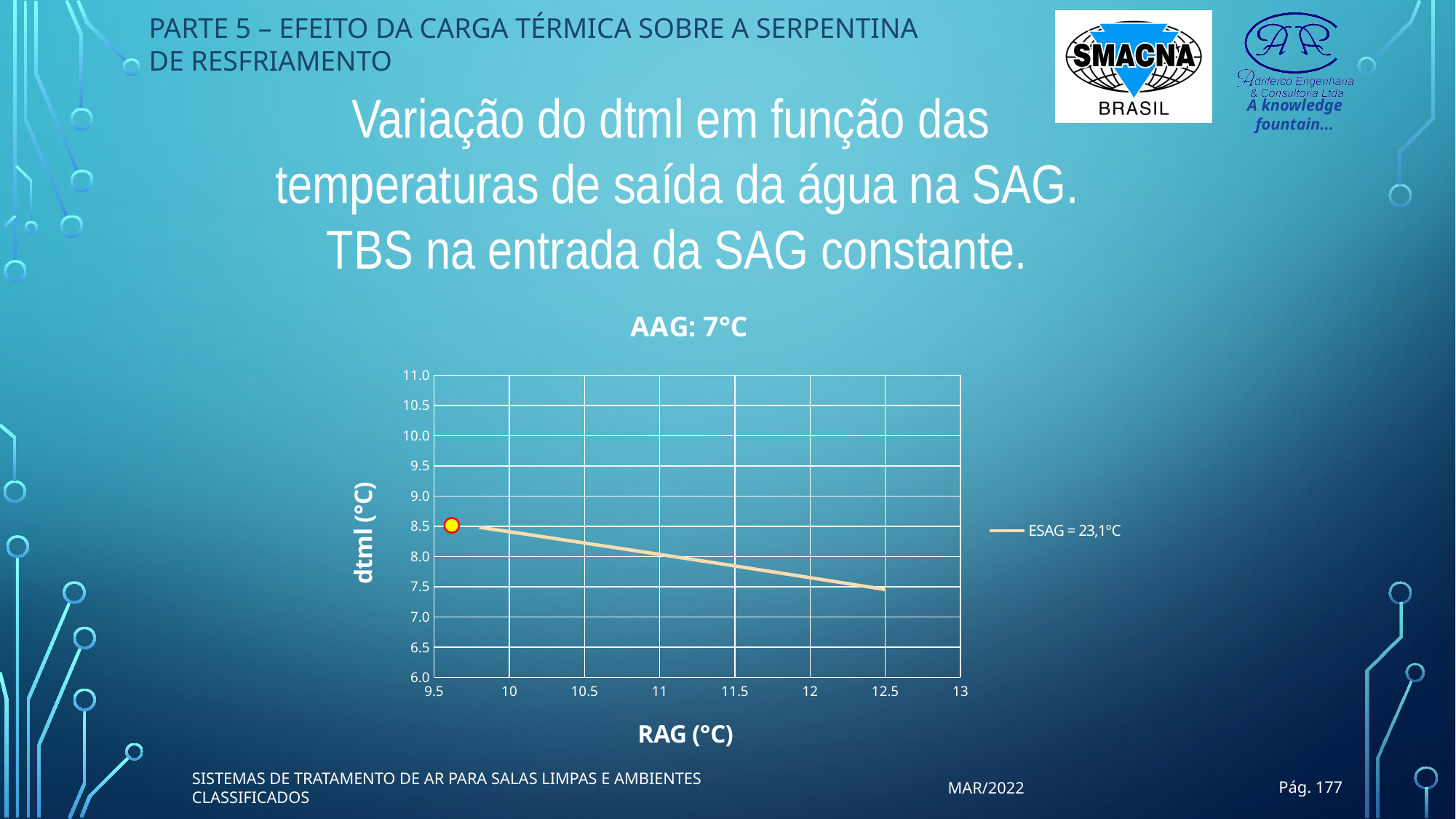
Is the dtml value at RAG 12.5 greater or less than 7.0? greater How many series does the chart legend list? 1 Does dtml rise or fall as RAG increases along the x axis? fall What kind of chart is shown on the slide? line chart Is the dtml value at RAG 10 greater or less than 9.0? less Is the dtml value at RAG 12.5 greater or less than 8.0? less What is the legend entry for the plotted line? ESAG = 23,1°C Which has the larger dtml value, RAG 10 or RAG 12.5? RAG 10 What is the title of the chart? AAG: 7°C